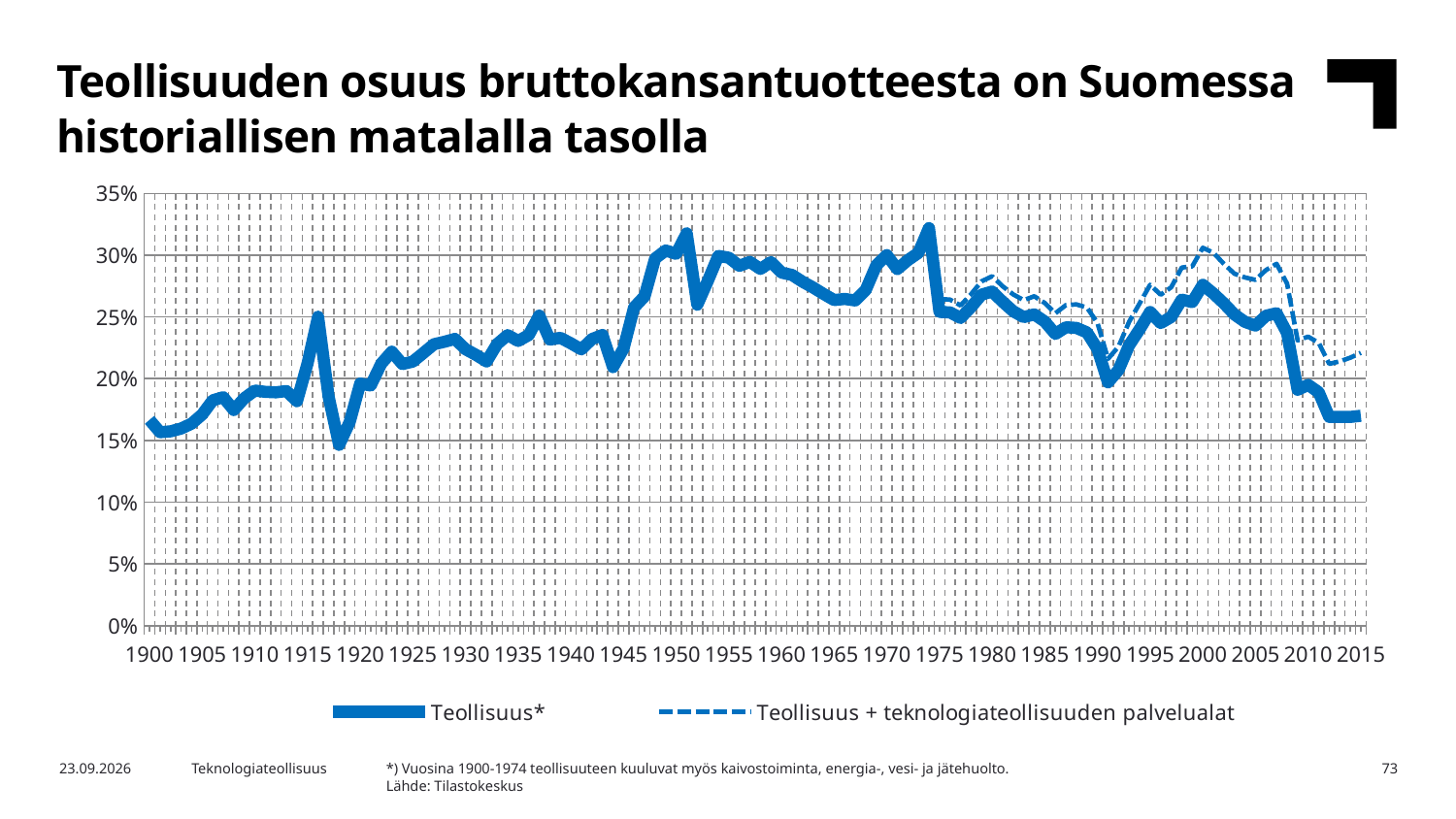
How many series does the legend list? 2 Is the value for Teollisuus* in 1950 greater or less than 25%? greater In 2010, which series has the higher value: Teollisuus* or Teollisuus + teknologiateollisuuden palvelualat? Teollisuus + teknologiateollisuuden palvelualat Is the value for Teollisuus* in 2015 greater or less than 20%? less Does the Teollisuus* line rise or fall between 2007 and 2015? fall Does the Teollisuus* line rise or fall between 1918 and 1950? rise Is the value for Teollisuus* in 1918 greater or less than 20%? less What kind of chart is shown on the slide? line chart What is the highest value shown on the vertical axis? 35% Which series is drawn with a dashed line? Teollisuus + teknologiateollisuuden palvelualat